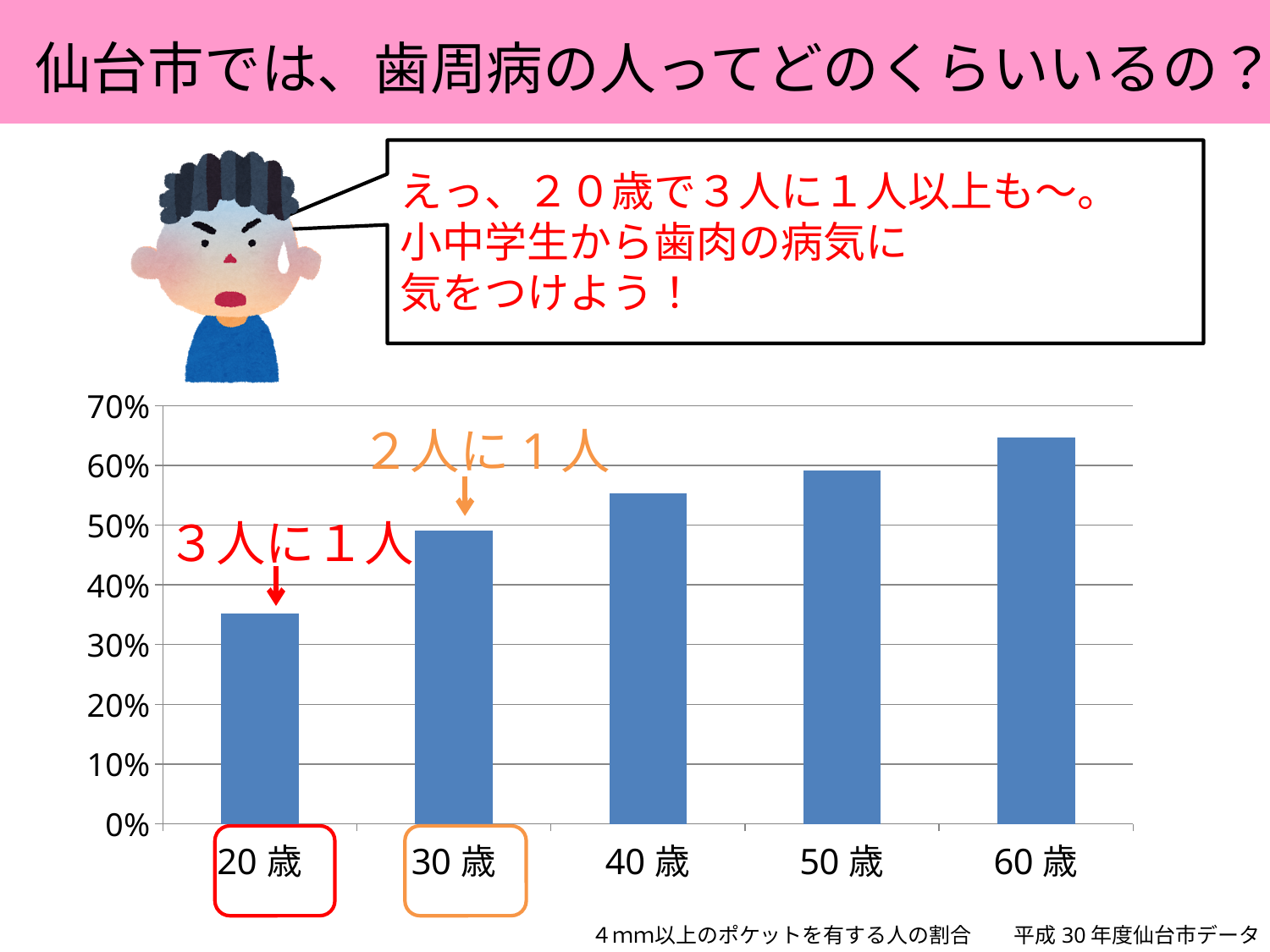
Is the value for 40歳 greater or less than 50%? greater Which age category has the lowest value? 20歳 Which age category has the highest value? 60歳 What kind of chart is shown on the slide? bar chart Is the value for 30歳 greater or less than 40%? greater Do the values rise or fall as age increases along the x axis? rise Which is larger, the value for 50歳 or the value for 30歳? 50歳 Which age category does the red annotation "3人に1人" point to? 20歳 Is the value for 60歳 greater or less than 60%? greater How many age categories are plotted on the chart? 5 Which age category does the orange annotation "2人に1人" point to? 30歳